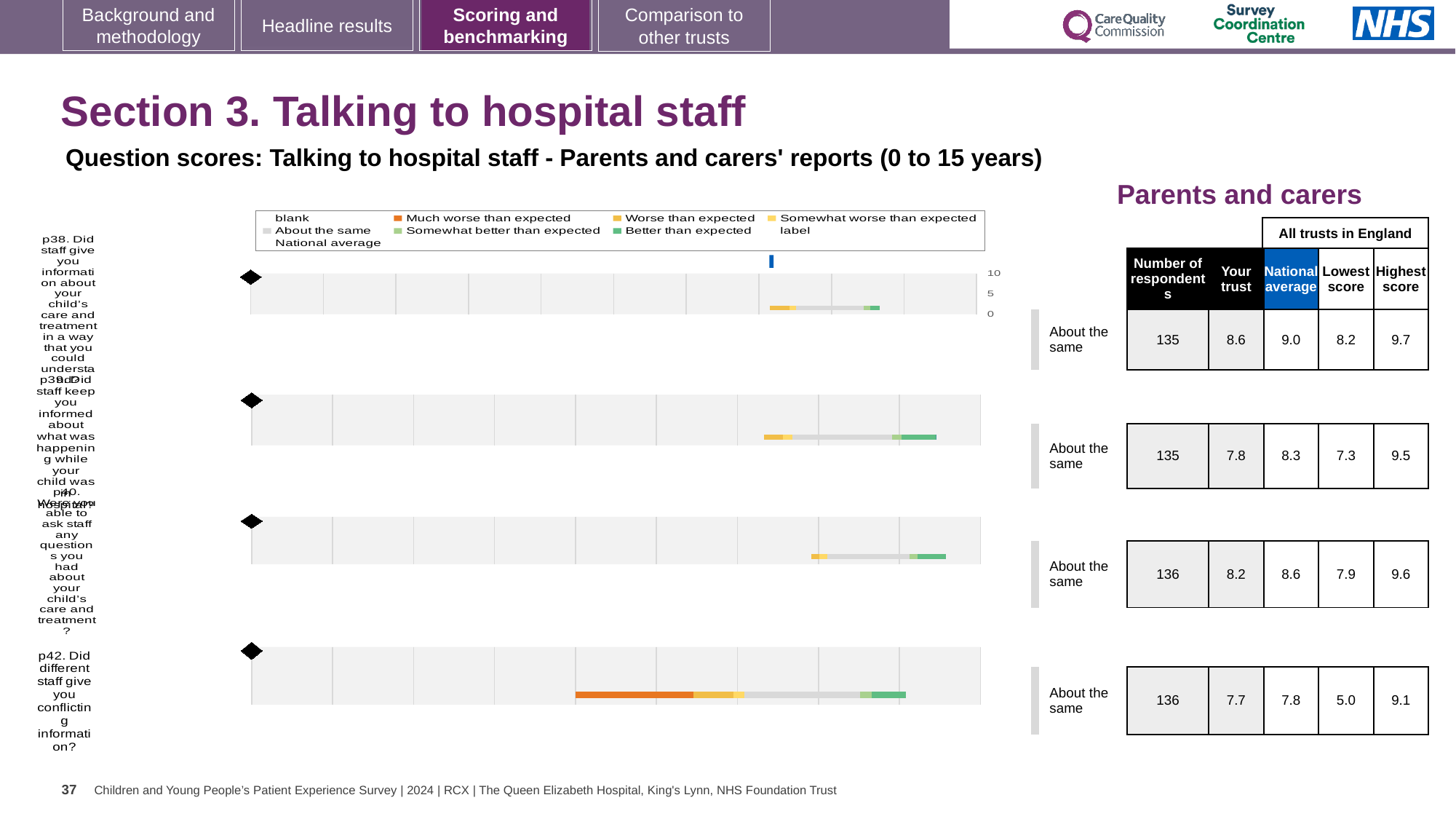
In the table, what is the Highest score for p38? 9.7 Which question has the lowest 'Your trust' score in the table? p42 Which question has the highest 'Your trust' score in the table? p38 How many survey questions (rows) are plotted on the slide? 4 Which has the larger 'Your trust' score, p38 or p39? p38 What benchmark category label is shown next to each of the four question charts? About the same In the table, how many respondents are listed for p40 (Were you able to ask staff any questions you had about your child's care and treatment?)? 136 In the table, what is the Lowest score for p42 (Did different staff give you conflicting information?)? 5.0 What kind of chart is used to show the question scores on this slide? Bar chart In the table, what is the 'Your trust' score for p38 (Did staff give you information about your child's care and treatment in a way that you could understand?)? 8.6 For p40, what is the difference between the National average and the 'Your trust' score? 0.4 In the table, what is the National average for p39 (Did staff keep you informed about what was happening while your child was in hospital?)? 8.3